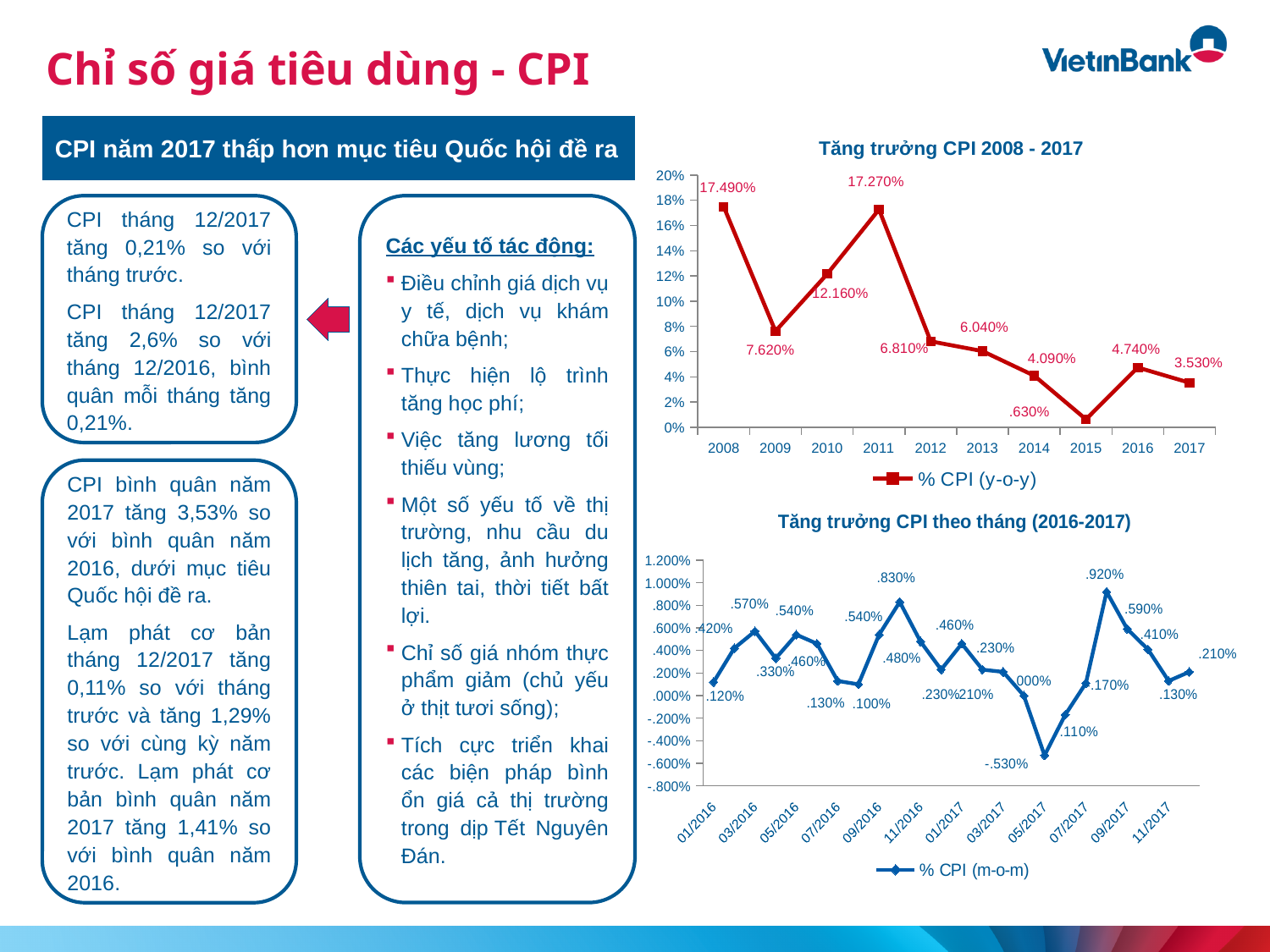
In the chart titled 'Tăng trưởng CPI 2008 - 2017', what is the value for 2008? 17.490% In the chart titled 'Tăng trưởng CPI 2008 - 2017', how many years are plotted? 10 In the chart titled 'Tăng trưởng CPI 2008 - 2017', what is the value for 2017? 3.530% In the chart titled 'Tăng trưởng CPI 2008 - 2017', what is the difference between the values for 2011 and 2012? 10.460% In the chart titled 'Tăng trưởng CPI 2008 - 2017', what is the value for 2015? .630% In the chart titled 'Tăng trưởng CPI 2008 - 2017', what is the legend entry for the plotted series? % CPI (y-o-y) In the chart titled 'Tăng trưởng CPI 2008 - 2017', which year has the lowest value? 2015 In the chart titled 'Tăng trưởng CPI 2008 - 2017', which year has the highest value? 2008 In the chart titled 'Tăng trưởng CPI 2008 - 2017', which is larger, the value for 2010 or the value for 2013? 2010 What type of chart is 'Tăng trưởng CPI theo tháng (2016-2017)'? Line chart In the chart titled 'Tăng trưởng CPI theo tháng (2016-2017)', what is the lowest data label shown? -.530% In the chart titled 'Tăng trưởng CPI theo tháng (2016-2017)', what is the highest data label shown? .920%